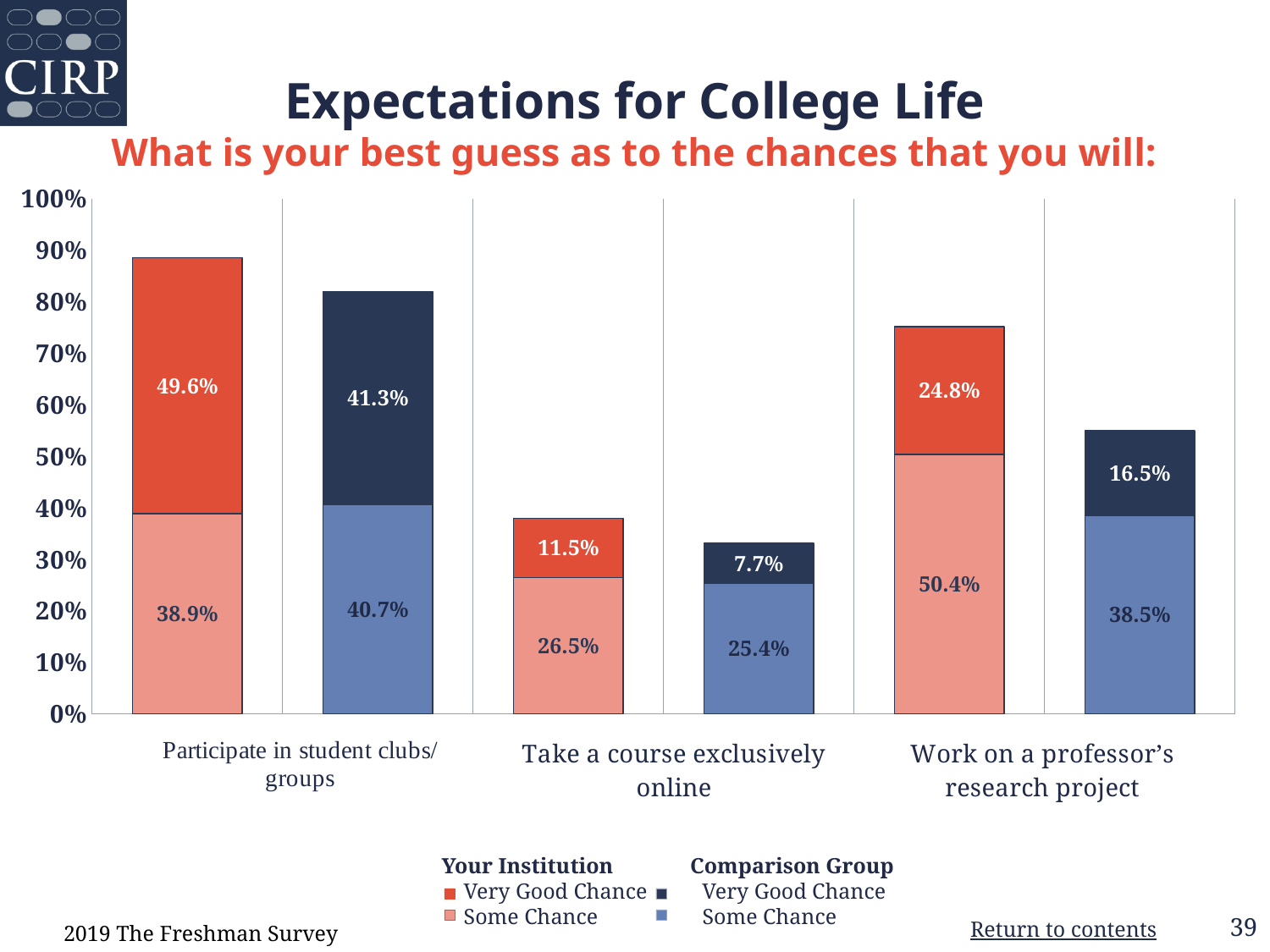
What type of chart is shown on the slide? Stacked bar chart What is the total stacked value of the Your Institution bar for participating in student clubs/groups? 88.5% Which activity has the lowest Very Good Chance value for the Comparison Group? Take a course exclusively online What is the total stacked value of the Comparison Group bar for taking a course exclusively online? 33.1% Which is larger: the Your Institution Very Good Chance value for taking a course exclusively online or the Comparison Group's? Your Institution What is the difference between the Your Institution and Comparison Group Very Good Chance values for working on a professor's research project? 8.3% What is the Your Institution Some Chance value for working on a professor's research project? 50.4% How many activity categories are shown on the x axis? 3 What percentage of Your Institution students say there is a Very Good Chance they will participate in student clubs/groups? 49.6% What is the Comparison Group's Some Chance value for taking a course exclusively online? 25.4% What is the Comparison Group's Very Good Chance value for working on a professor's research project? 16.5% Which activity has the highest Very Good Chance value for Your Institution? Participate in student clubs/groups